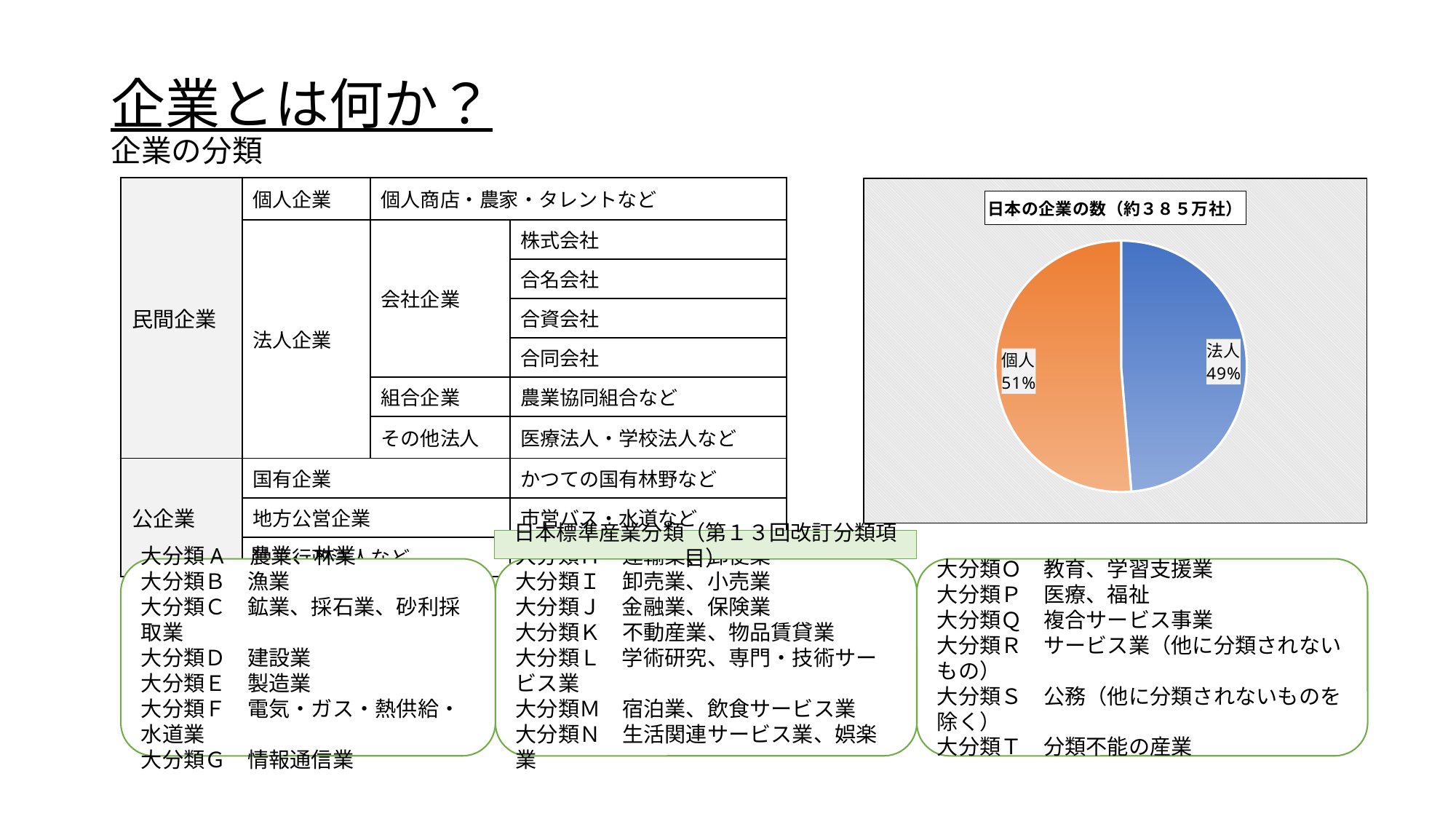
Which slice of the pie chart is the largest? 個人 How many slices does the pie chart have? 2 What is the title of the pie chart? 日本の企業の数（約３８５万社） What colour is the 法人 slice of the pie chart? blue What is the difference in percentage points between the 個人 and 法人 slices? 2 What kind of chart is shown on the slide? pie chart What share of the pie does 個人 represent? 51% Which is larger in the pie chart, 個人 or 法人? 個人 Is the share for 法人 greater or less than 50%? less What share of the pie does 法人 represent? 49% Which slice of the pie chart is the smallest? 法人